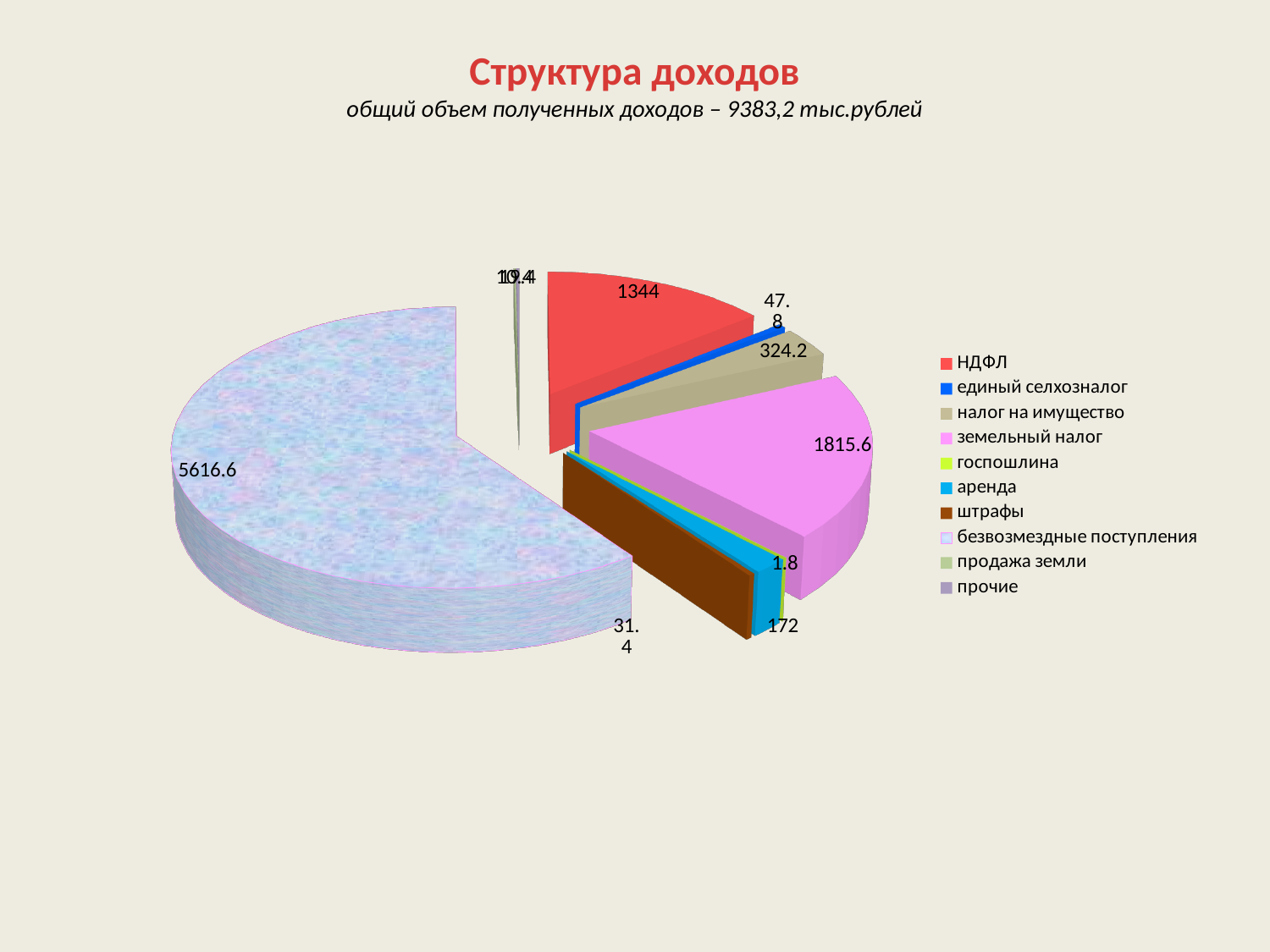
What is the value shown for земельный налог? 1815.6 What is the value shown for НДФЛ? 1344 What kind of chart is shown on the slide? pie chart What is the value shown for безвозмездные поступления? 5616.6 What is the value shown for налог на имущество? 324.2 What is the value shown for госпошлина? 1.8 What is the title of the chart on the slide? Структура доходов How many categories does the legend list? 10 Which is larger, the value for штрафы or the value for единый селхозналог? единый селхозналог What is the difference between the values for земельный налог and НДФЛ? 471.6 What is the value shown for аренда? 172 Which category has the largest slice of the pie? безвозмездные поступления